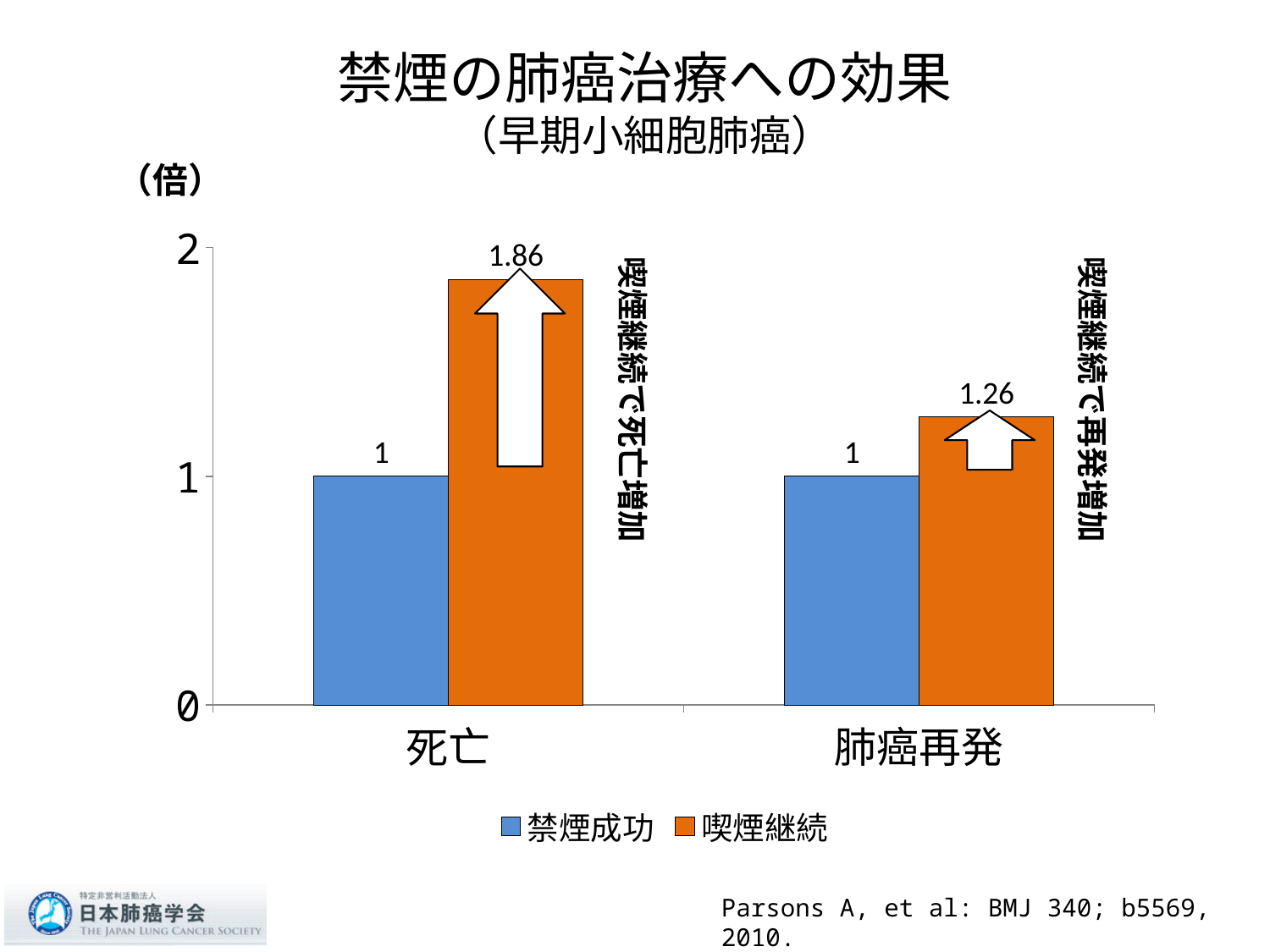
What is the value for 喫煙継続 in the 死亡 category? 1.86 What is the difference between the 喫煙継続 and 禁煙成功 values in the 死亡 category? 0.86 What kind of chart is shown on the slide? Bar chart Which is larger: the 喫煙継続 value for 死亡 or for 肺癌再発? 死亡 What is the value for 禁煙成功 in the 死亡 category? 1 Which category has the highest 喫煙継続 value? 死亡 How many series does the legend list? 2 What is the value for 喫煙継続 in the 肺癌再発 category? 1.26 What is the difference between the 喫煙継続 values for 死亡 and 肺癌再発? 0.6 How many categories are shown on the x axis? 2 What is the value for 禁煙成功 in the 肺癌再発 category? 1 Which category has the lowest 喫煙継続 value? 肺癌再発